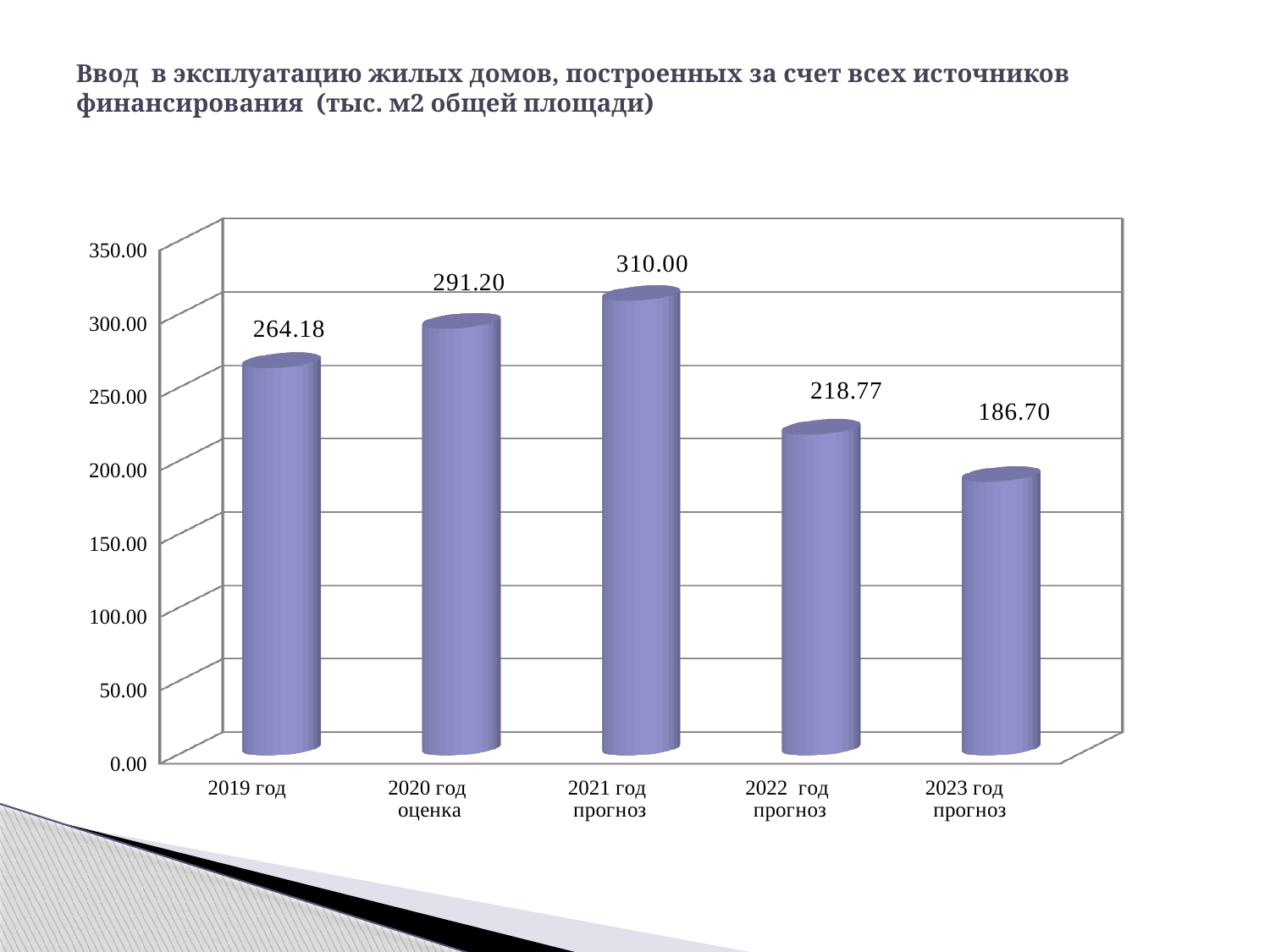
Which is larger, the value for 2020 год оценка or the value for 2022 год прогноз? 2020 год оценка What is the difference between the values for 2021 год прогноз and 2022 год прогноз? 91.23 What is the difference between the values for 2020 год оценка and 2019 год? 27.02 Which year has the lowest value? 2023 год прогноз Is the value for 2022 год прогноз greater or less than 250.00? less Do the values rise or fall from 2021 год прогноз to 2023 год прогноз? fall What kind of chart is shown on the slide? bar chart How many categories are shown on the x axis? 5 What is the value for 2019 год? 264.18 Which year has the highest value? 2021 год прогноз What is the value for 2021 год прогноз? 310.00 What is the value for 2023 год прогноз? 186.70